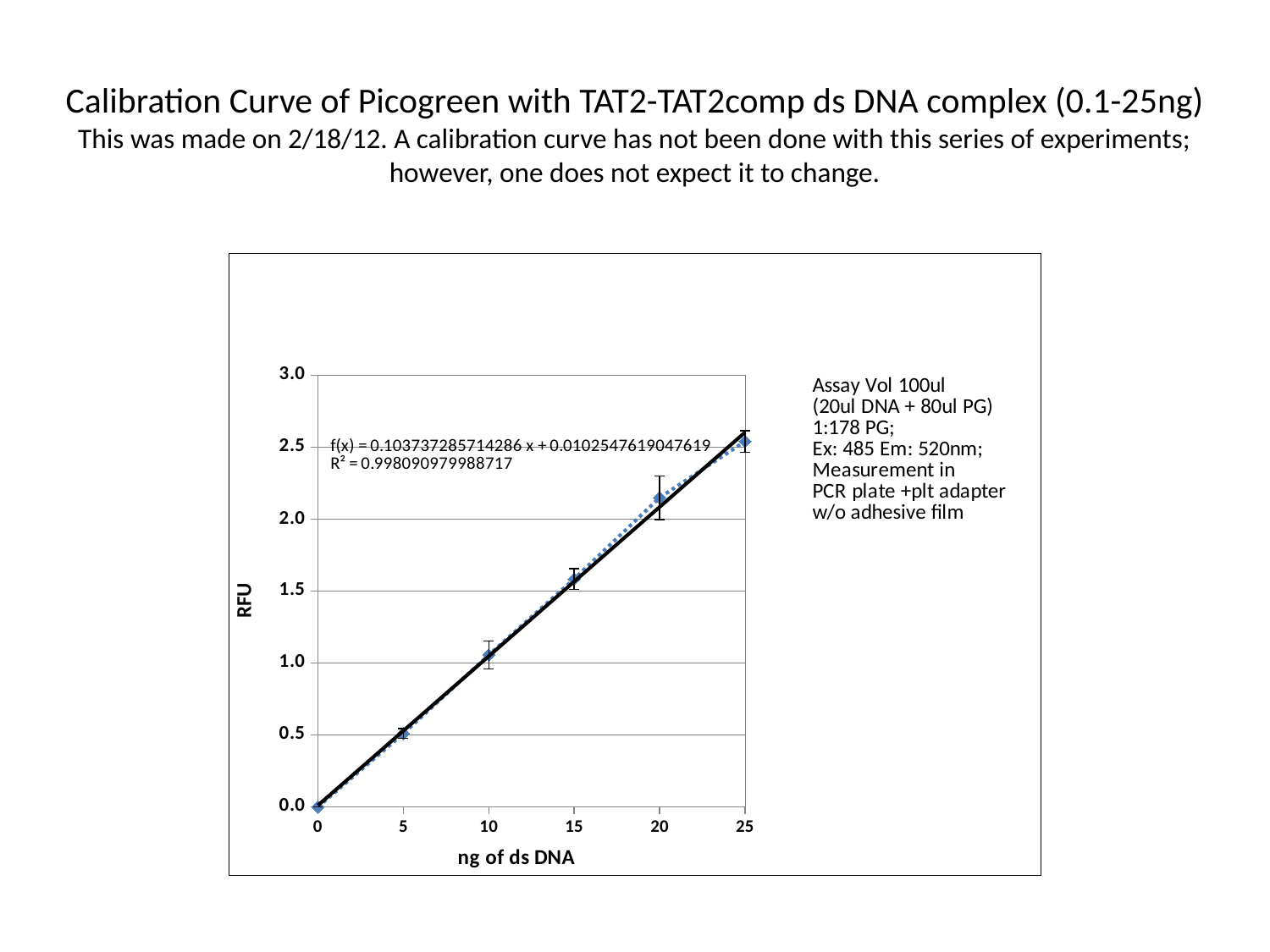
Which has the larger RFU value: 5 ng or 15 ng of ds DNA? 15 ng At which ng of ds DNA value is the RFU lowest? 0 Is the RFU value at 20 ng of ds DNA greater or less than 2.0? greater Do the RFU values rise or fall as ng of ds DNA increases along the x axis? rise What is the label of the y axis? RFU How many data points are plotted on the chart? 6 Is the RFU value at 15 ng of ds DNA greater or less than 1.5? greater At which ng of ds DNA value is the RFU highest? 25 What R² value is printed on the chart for the trendline? 0.998090979988717 Is the RFU value at 10 ng of ds DNA greater or less than 1.5? less What kind of chart is shown on the slide? scatter plot with a linear trendline